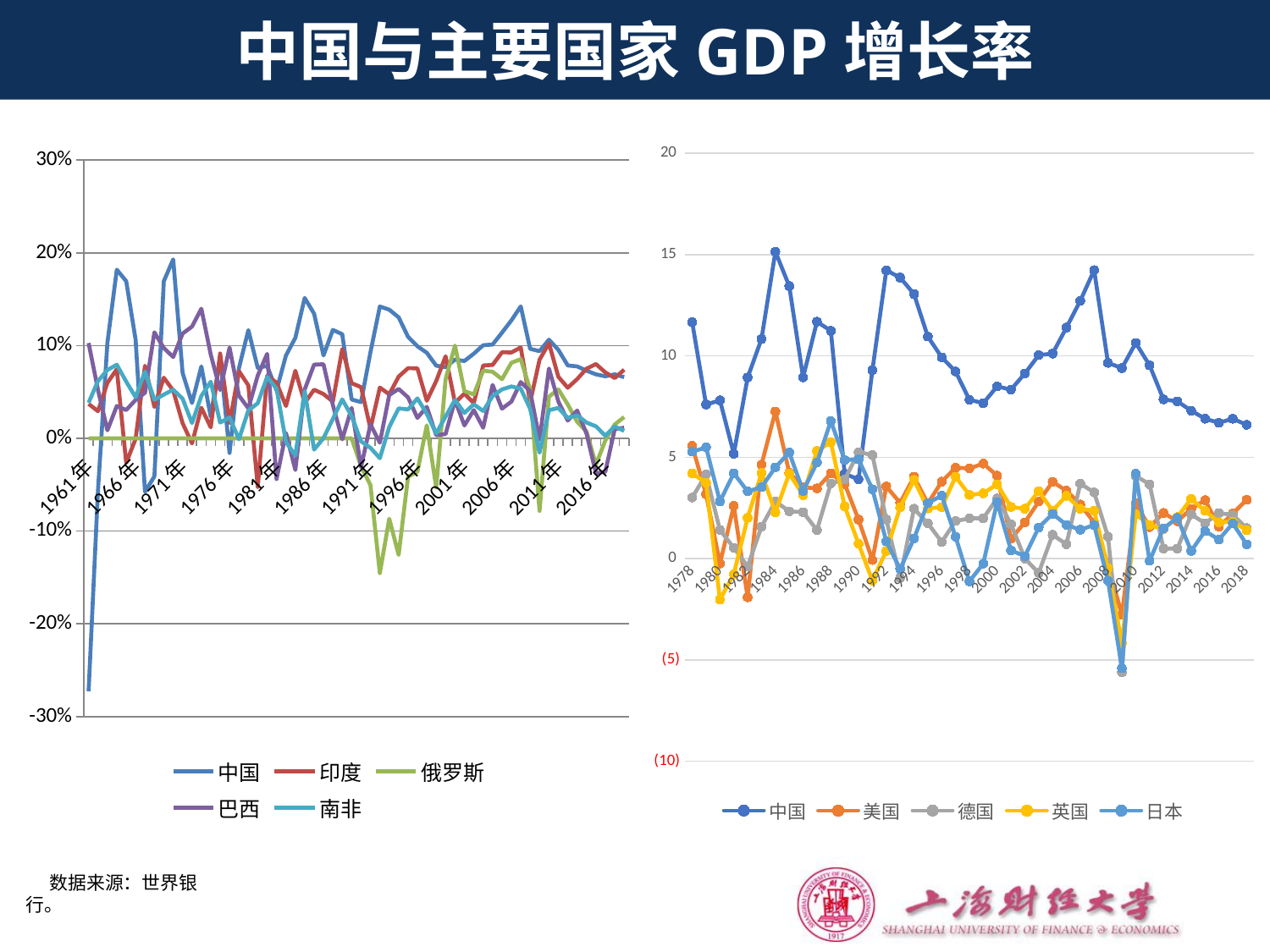
How many series does the legend of the left chart list? 5 In the left chart, is the lowest value of the 俄罗斯 series (in the early 1990s) greater or less than -10%? less What is the title of the slide containing the two charts? 中国与主要国家 GDP 增长率 What kind of chart is the left chart on the slide? line chart What kind of chart is the right chart on the slide? line chart In the left chart, is the lowest value of the 中国 series (around 1961) greater or less than -20%? less In the right chart, does the 中国 series rise or fall from 2010 to 2018? fall How many series does the legend of the right chart list? 5 Which series are listed in the legend of the right chart? 中国, 美国, 德国, 英国, 日本 In the right chart, is the value for 中国 in 2018 greater or less than 5? greater